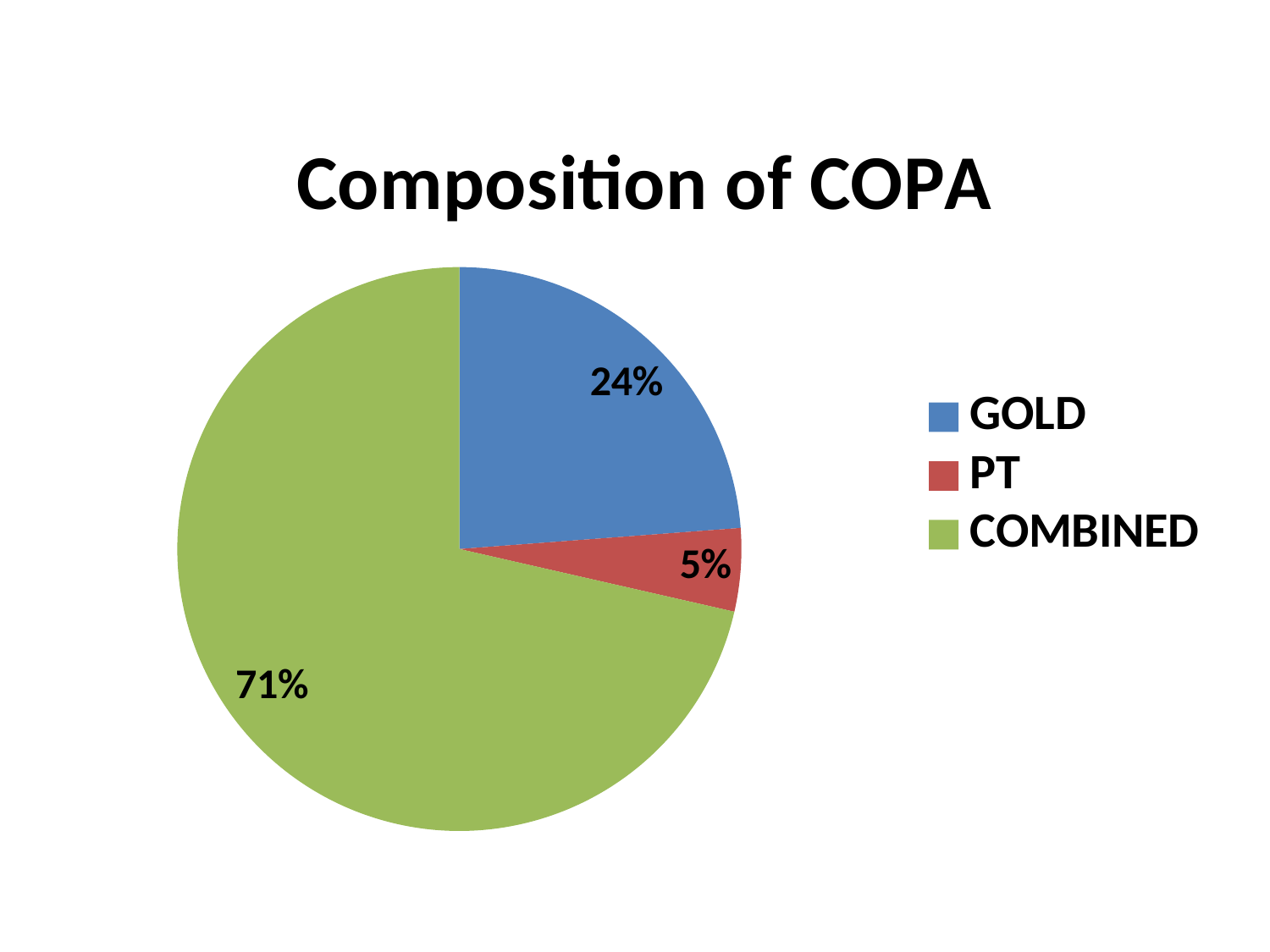
Which category has the largest slice of the pie? COMBINED What is the difference in percentage points between the GOLD slice and the PT slice? 19 What is the difference in percentage points between the COMBINED slice and the GOLD slice? 47 Which colour represents COMBINED in the legend? green What kind of chart is shown on the slide? pie chart What share of the pie does GOLD represent? 24% Which slice is larger, GOLD or PT? GOLD Which category has the smallest slice of the pie? PT What is the title of the chart? Composition of COPA What share of the pie does PT represent? 5% How many slices does the pie chart have? 3 What share of the pie does COMBINED represent? 71%